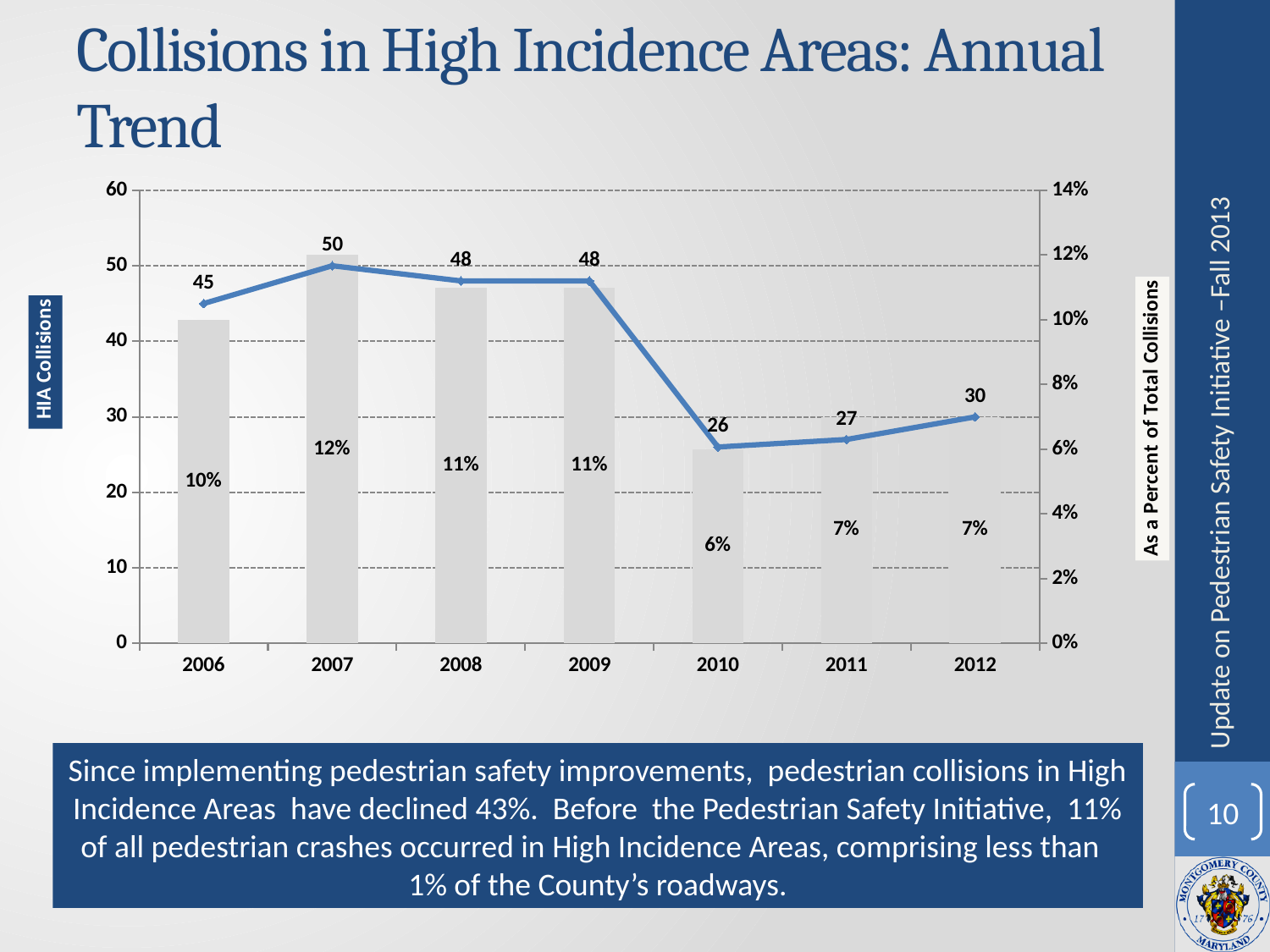
Which year has the highest number of HIA collisions? 2007 What percent of total collisions occurred in High Incidence Areas in 2007? 12% Do HIA collisions generally rise or fall from 2009 to 2010? fall Which year has the lowest number of HIA collisions? 2010 What percent of total collisions occurred in High Incidence Areas in 2012? 7% What is the number of HIA collisions in 2010? 26 What is the label of the right-hand vertical axis? As a Percent of Total Collisions How many years are shown on the x axis? 7 What is the number of HIA collisions in 2006? 45 What is the difference in HIA collisions between 2007 and 2010? 24 Which year has more HIA collisions, 2011 or 2012? 2012 What is the difference in percent of total collisions between 2007 and 2010? 6%